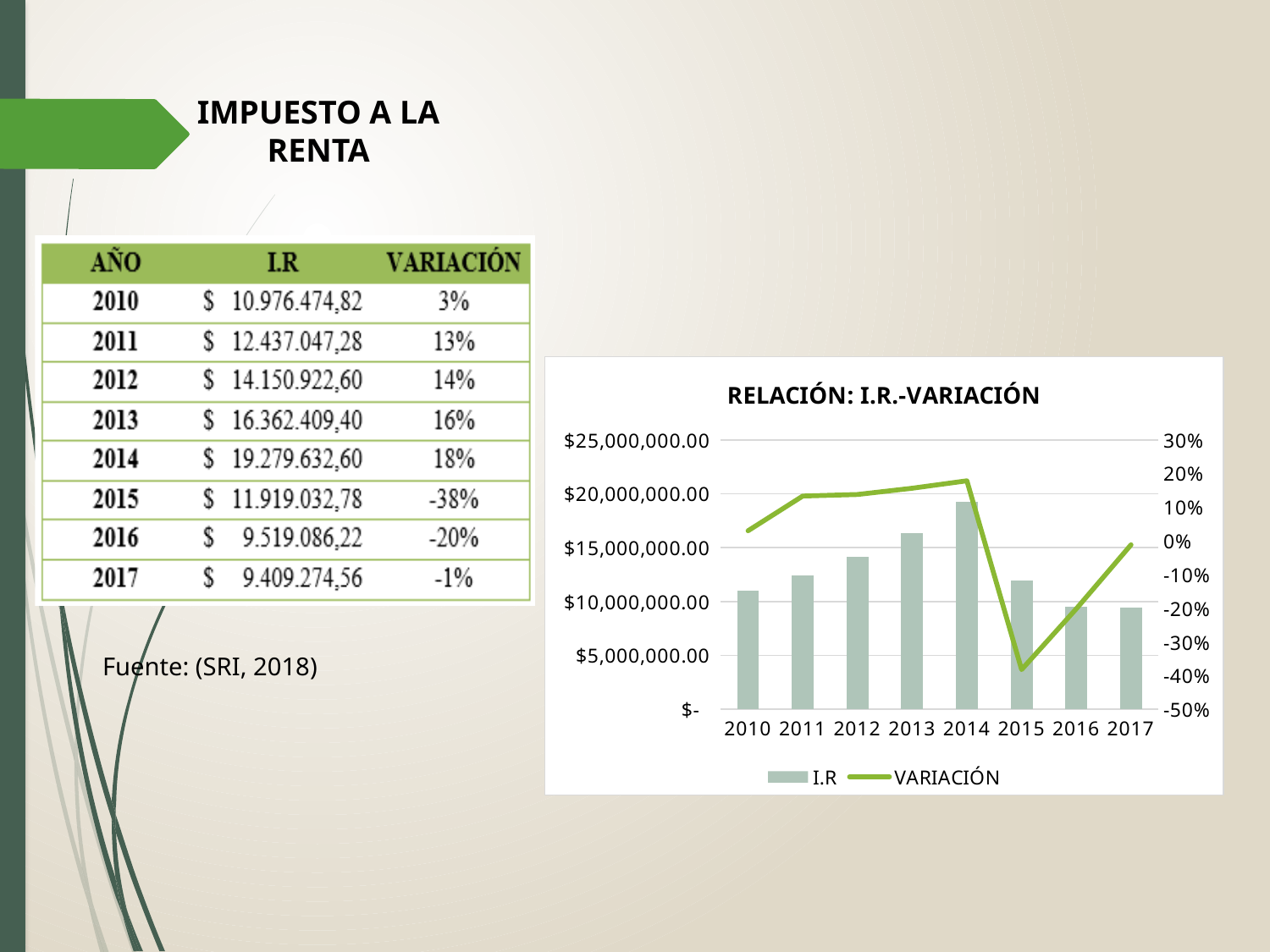
Is the VARIACIÓN value for 2015 greater or less than -30%? less Is the I.R bar for 2015 greater or less than $15,000,000.00? less Is the I.R bar for 2014 greater or less than $15,000,000.00? greater What is the title of the chart? RELACIÓN: I.R.-VARIACIÓN Do the I.R bars rise or fall from 2010 to 2014? rise Which year has the highest I.R bar in the chart? 2014 How many series does the chart legend list? 2 Which year has the larger I.R bar, 2012 or 2015? 2012 Which series in the chart is drawn as a line? VARIACIÓN How many years are shown on the x axis of the chart? 8 Which year has the lowest point on the VARIACIÓN line in the chart? 2015